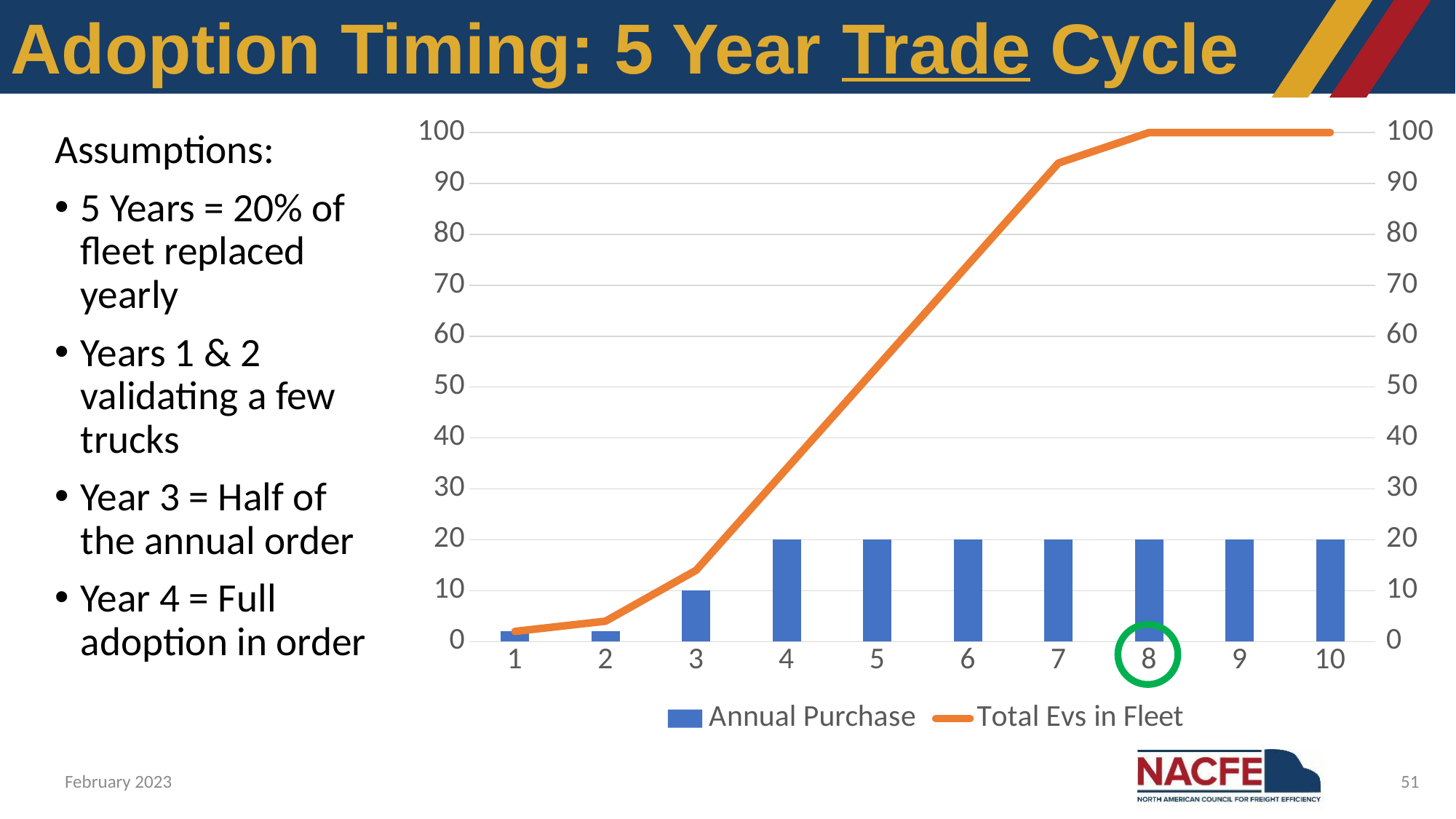
What is the difference between the Annual Purchase for year 4 and year 3? 10 What is the Annual Purchase value for year 3? 10 Is the Total Evs in Fleet value for year 6 greater or less than 70? greater How many years are shown on the x axis of the chart? 10 What kind of chart is shown on the slide? Combination bar and line chart What is the Total Evs in Fleet value for year 10? 100 Which is larger, the Annual Purchase for year 3 or for year 4? Year 4 Does the Total Evs in Fleet line rise or fall from year 1 to year 8? Rise How many series does the legend list? 2 Is the Total Evs in Fleet value for year 4 greater or less than 30? greater Is the Total Evs in Fleet value for year 7 greater or less than 90? greater What is the Annual Purchase value for year 5? 20